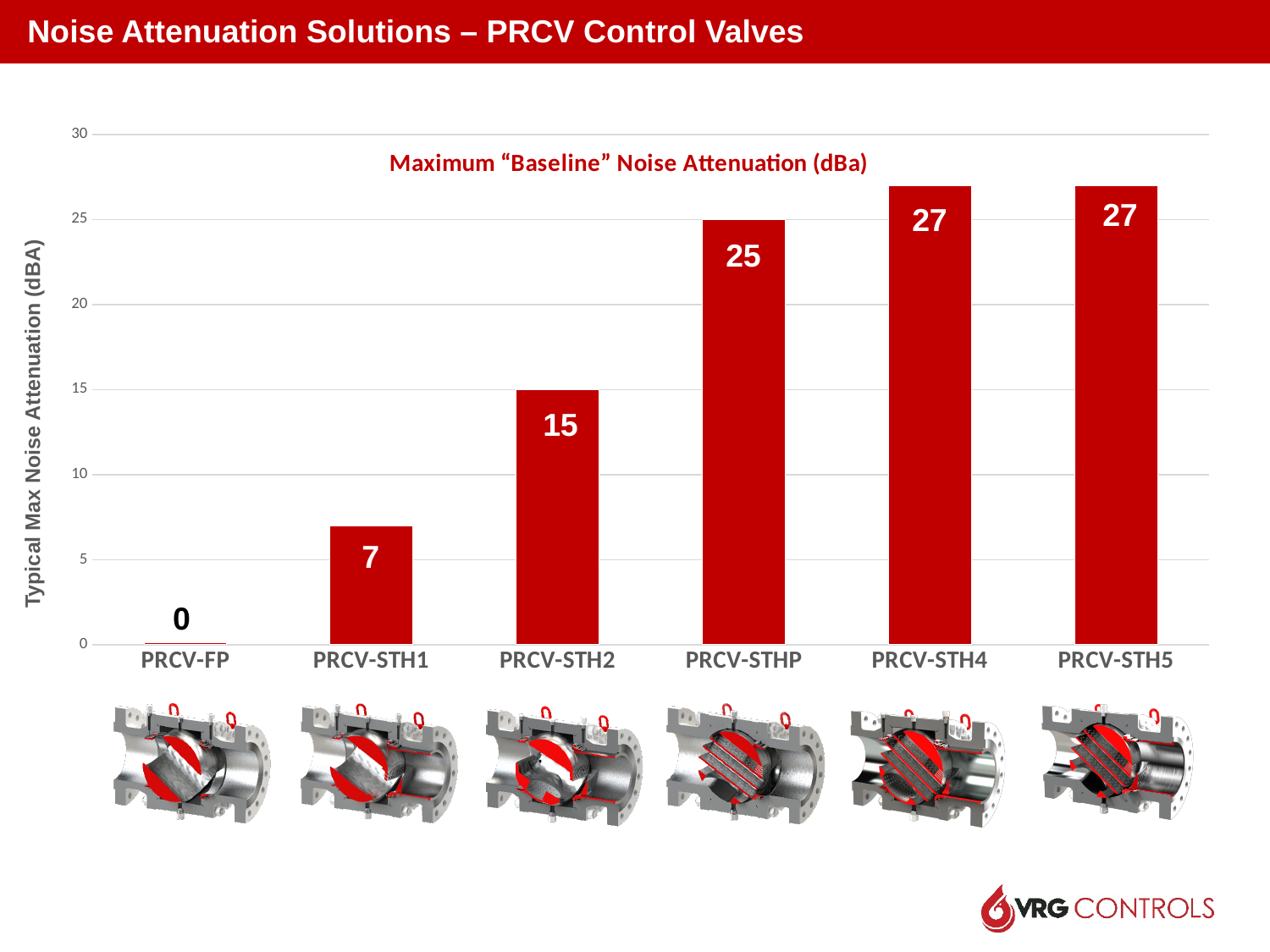
What is the difference between the values for PRCV-STH4 and PRCV-STH1? 20 What is the value for PRCV-FP? 0 What is the difference between the values for PRCV-STHP and PRCV-STH2? 10 What is the value for PRCV-STH2? 15 What kind of chart is shown? bar chart Which is larger, the value for PRCV-STH2 or the value for PRCV-STH1? PRCV-STH2 Is the value for PRCV-STH5 greater or less than 20? greater What is the value for PRCV-STH1? 7 Which category has the lowest value? PRCV-FP What is the value for PRCV-STHP? 25 What is the title of the chart? Maximum "Baseline" Noise Attenuation (dBa) How many categories are shown on the x axis? 6